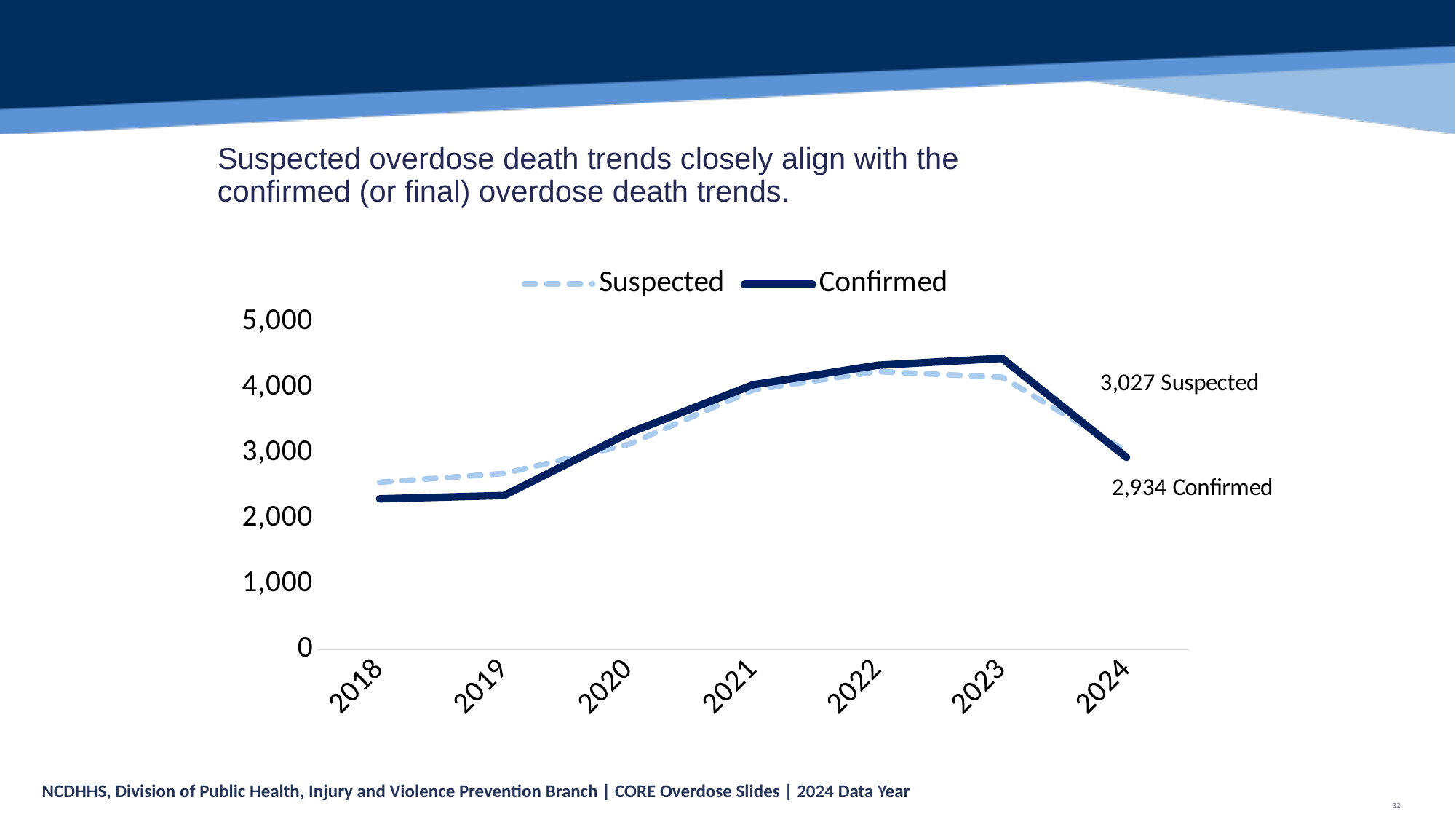
What is the Suspected value for 2024? 3,027 In 2024, which is larger, the Suspected value or the Confirmed value? Suspected Is the Confirmed value for 2018 greater or less than 3,000? less Is the Suspected value for 2019 greater or less than 3,000? less How many series does the legend list? 2 Does the Confirmed series rise or fall from 2023 to 2024? fall What kind of chart is shown on the slide? line chart What is the Confirmed value for 2024? 2,934 Is the Confirmed value for 2022 greater or less than 4,000? greater In which year does the Confirmed series reach its highest value? 2023 What is the difference between the Suspected and Confirmed values in 2024? 93 How many years are shown on the x axis? 7